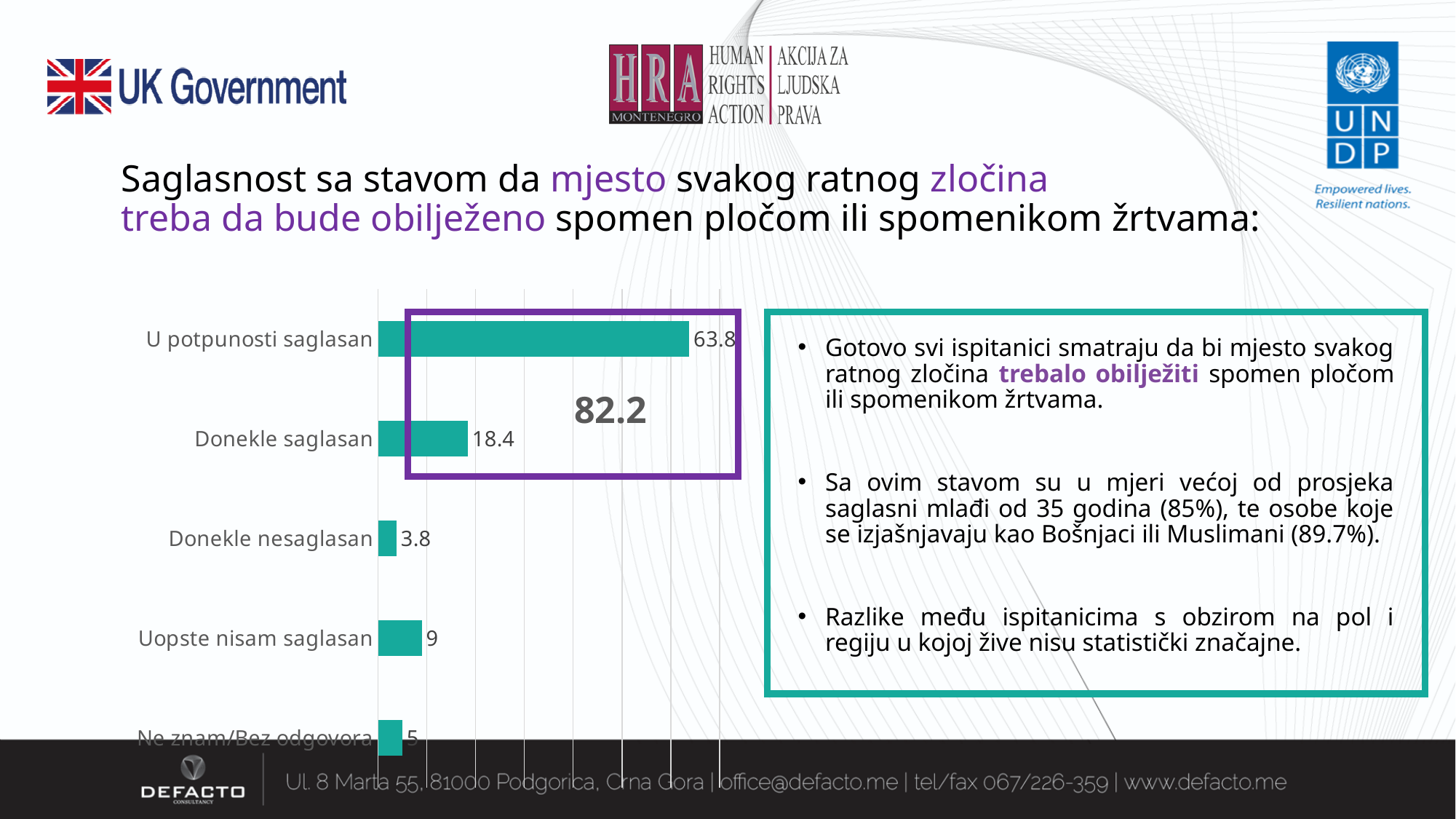
What kind of chart is shown on the slide? Bar chart What is the value for "U potpunosti saglasan"? 63.8 What is the value for "Ne znam/Bez odgovora"? 5 What is the difference between the values for "U potpunosti saglasan" and "Donekle saglasan"? 45.4 Which category has the lowest value? Donekle nesaglasan What is the value for "Donekle nesaglasan"? 3.8 How many categories are shown in the chart? 5 What is the value for "Donekle saglasan"? 18.4 Which category has the highest value? U potpunosti saglasan Which is larger, the value for "Uopste nisam saglasan" or the value for "Ne znam/Bez odgovora"? Uopste nisam saglasan What combined value is printed inside the purple box around the first two bars? 82.2 What is the value for "Uopste nisam saglasan"? 9